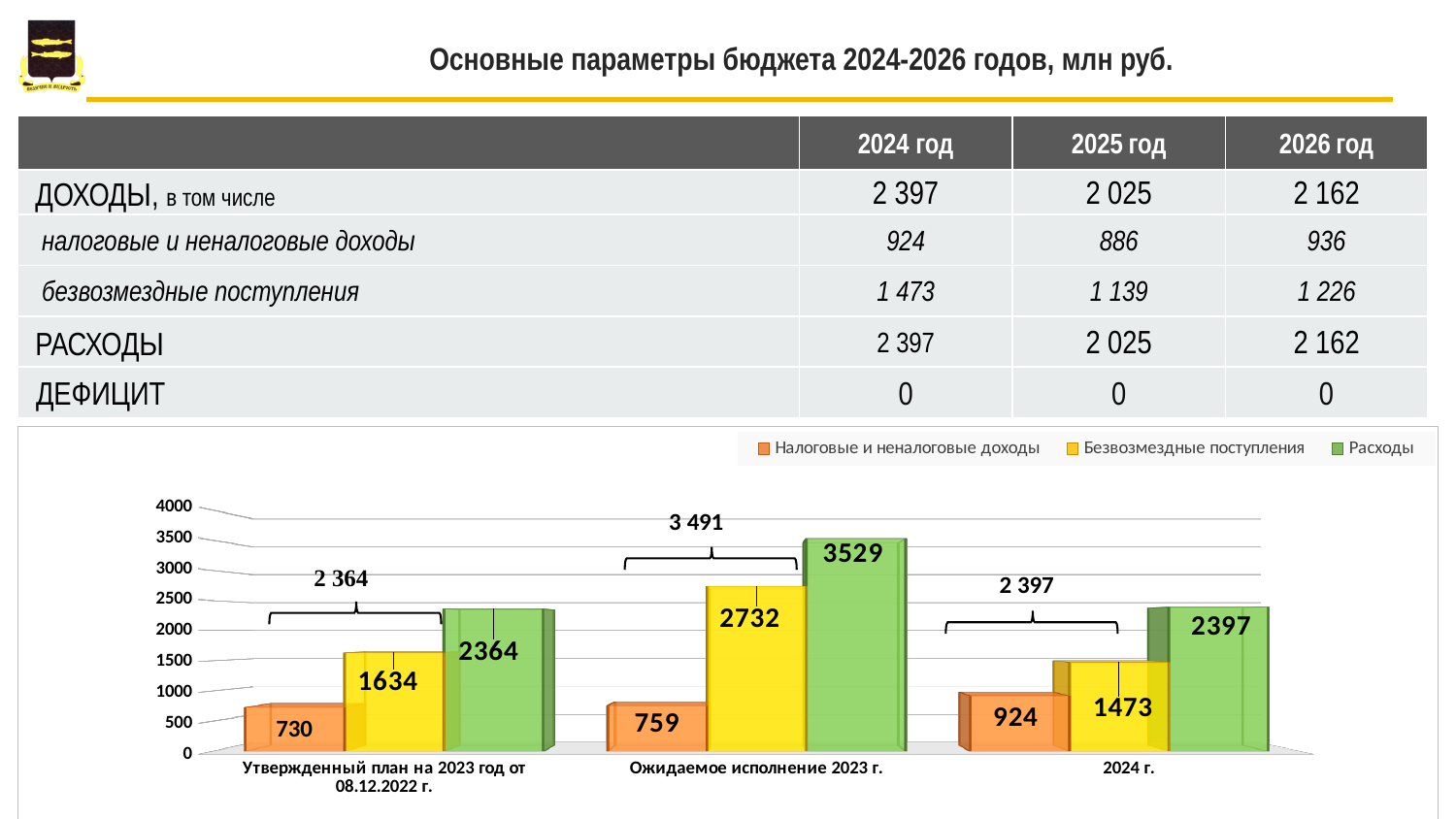
How many categories are shown along the x axis of the chart? 3 What kind of chart is shown on the slide? bar chart Which is larger: Безвозмездные поступления for 'Ожидаемое исполнение 2023 г.' or Безвозмездные поступления for '2024 г.'? Ожидаемое исполнение 2023 г. What total is shown by the bracket above the '2024 г.' category? 2 397 How many series does the chart legend list? 3 What is the difference between Расходы for 'Ожидаемое исполнение 2023 г.' and Расходы for '2024 г.'? 1132 Which category has the lowest value for Налоговые и неналоговые доходы? Утвержденный план на 2023 год от 08.12.2022 г. What is the value of Расходы for the category 'Ожидаемое исполнение 2023 г.'? 3529 What is the value of Налоговые и неналоговые доходы for the category 'Утвержденный план на 2023 год от 08.12.2022 г.'? 730 Which category has the highest value for Расходы? Ожидаемое исполнение 2023 г. What is the value of Безвозмездные поступления for the category '2024 г.'? 1473 Which colour represents Расходы in the chart legend? green